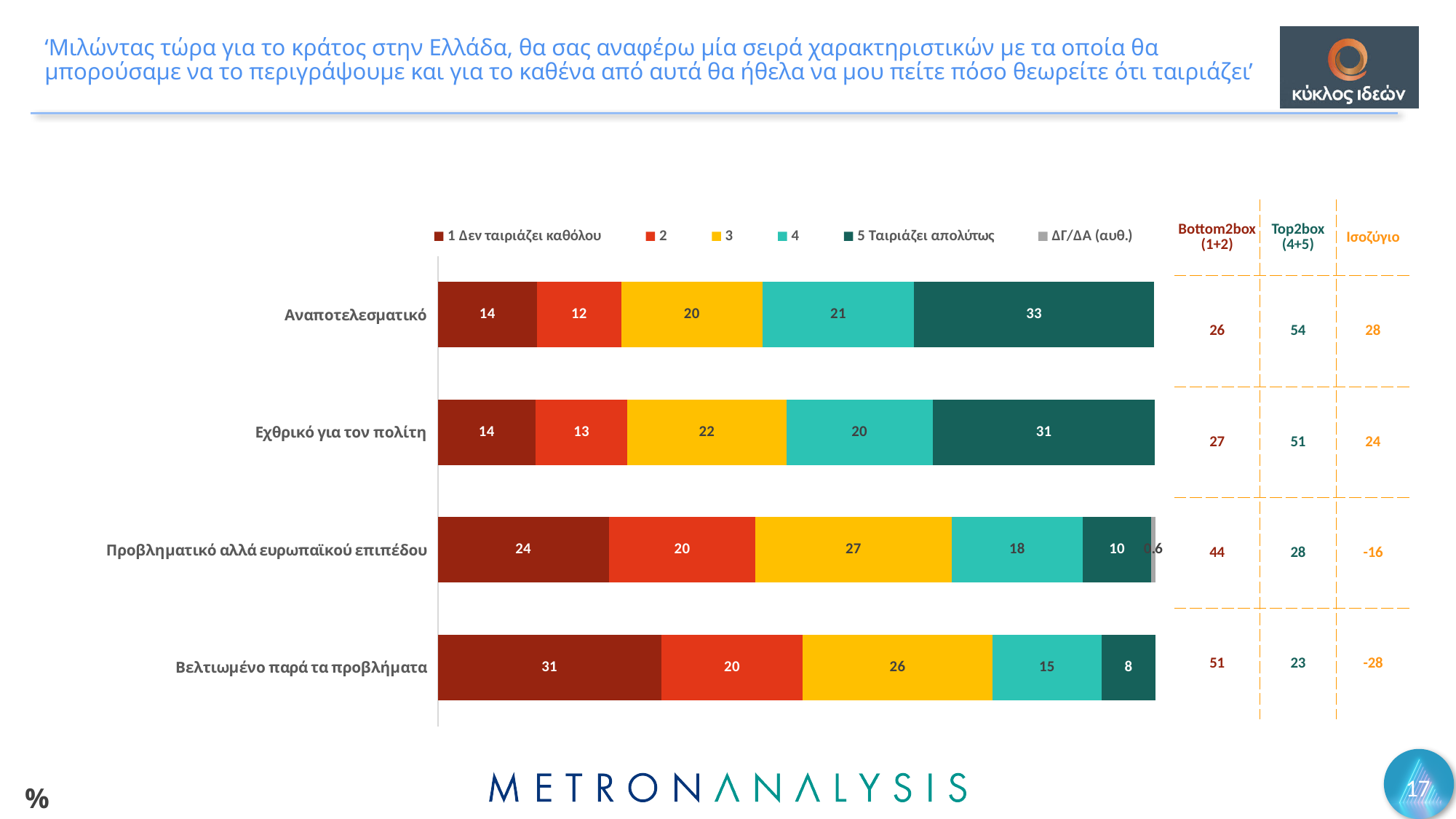
Which category has the lowest value for '5 Ταιριάζει απολύτως'? Βελτιωμένο παρά τα προβλήματα What is the value of the 'ΔΓ/ΔΑ (αυθ.)' segment for 'Προβληματικό αλλά ευρωπαϊκού επιπέδου'? 0.6 Which category has the highest value for '5 Ταιριάζει απολύτως'? Αναποτελεσματικό How many series does the legend list? 6 Which is larger: the '1 Δεν ταιριάζει καθόλου' segment for 'Βελτιωμένο παρά τα προβλήματα' or for 'Προβληματικό αλλά ευρωπαϊκού επιπέδου'? Βελτιωμένο παρά τα προβλήματα What is the value of the '5 Ταιριάζει απολύτως' segment for 'Αναποτελεσματικό'? 33 How many categories are shown in the chart? 4 What is the value of the '1 Δεν ταιριάζει καθόλου' segment for 'Βελτιωμένο παρά τα προβλήματα'? 31 What is the Top2box (4+5) value for 'Εχθρικό για τον πολίτη'? 51 What is the difference between the '3' segment for 'Προβληματικό αλλά ευρωπαϊκού επιπέδου' and the '3' segment for 'Αναποτελεσματικό'? 7 What is the Ισοζύγιο value for 'Βελτιωμένο παρά τα προβλήματα'? -28 What kind of chart is shown on the slide? Stacked bar chart